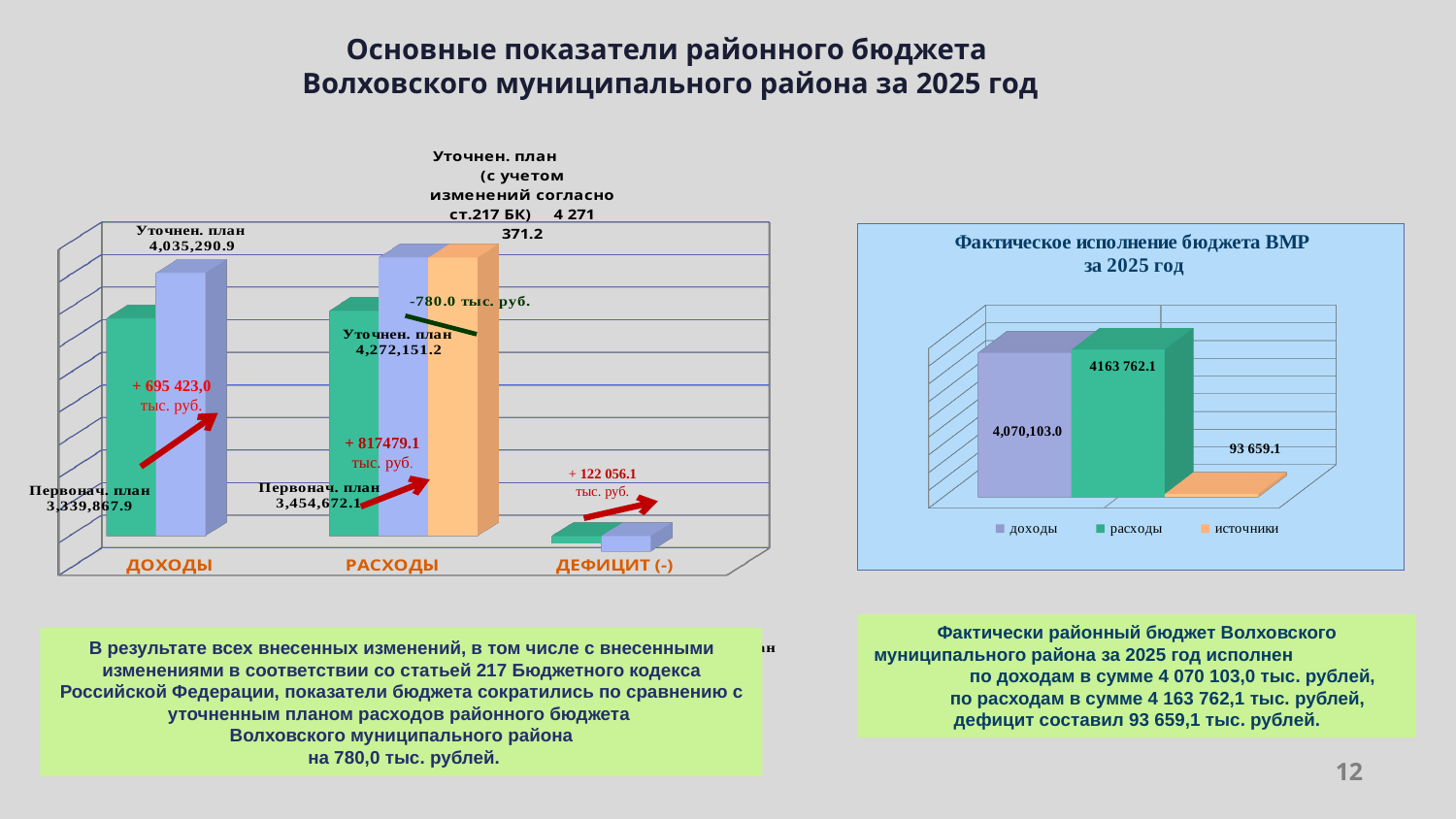
In the left chart, what is the Уточнен. план value for ДОХОДЫ? 4,035,290.9 In the chart titled 'Фактическое исполнение бюджета ВМР за 2025 год', which series has the lowest value? источники In the left chart, what is the Уточнен. план value for РАСХОДЫ? 4,272,151.2 In the chart titled 'Фактическое исполнение бюджета ВМР за 2025 год', how many series does the legend list? 3 In the chart titled 'Фактическое исполнение бюджета ВМР за 2025 год', what is the value for расходы? 4163 762.1 In the chart titled 'Фактическое исполнение бюджета ВМР за 2025 год', what is the value for источники? 93 659.1 In the chart titled 'Фактическое исполнение бюджета ВМР за 2025 год', which series has the highest value? расходы In the chart titled 'Фактическое исполнение бюджета ВМР за 2025 год', what is the value for доходы? 4,070,103.0 In the left chart, what is the Первонач. план value for РАСХОДЫ? 3,454,672.1 In the left chart, how many categories are shown on the x axis? 3 In the chart titled 'Фактическое исполнение бюджета ВМР за 2025 год', what kind of chart is shown? Bar chart In the left chart, what is the Первонач. план value for ДОХОДЫ? 3,339,867.9